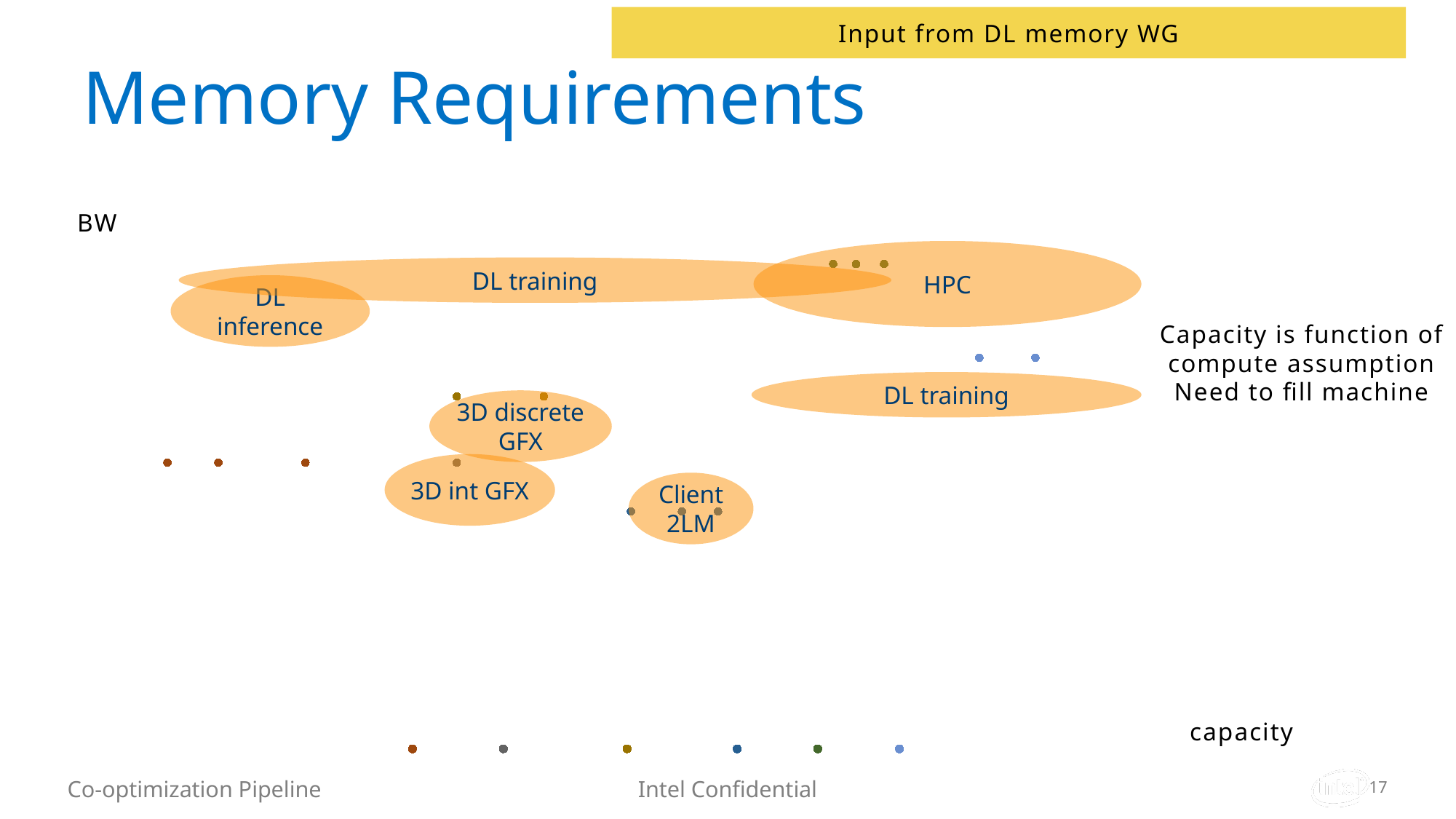
Which is placed further right on the capacity axis, the lower DL training region or 3D int GFX? DL training Which is placed higher on the BW axis, 3D discrete GFX or 3D int GFX? 3D discrete GFX What is the label on the horizontal axis of the chart? capacity What kind of chart is shown on the slide? scatter chart Which workload label appears twice on the chart? DL training Which is placed higher on the BW axis, HPC or Client 2LM? HPC What is the label on the vertical axis of the chart? BW Which labeled region is placed lowest on the BW axis? Client 2LM How many labeled regions (ellipses) are drawn on the chart? 7 Which labeled region is placed furthest to the left on the capacity axis? DL inference